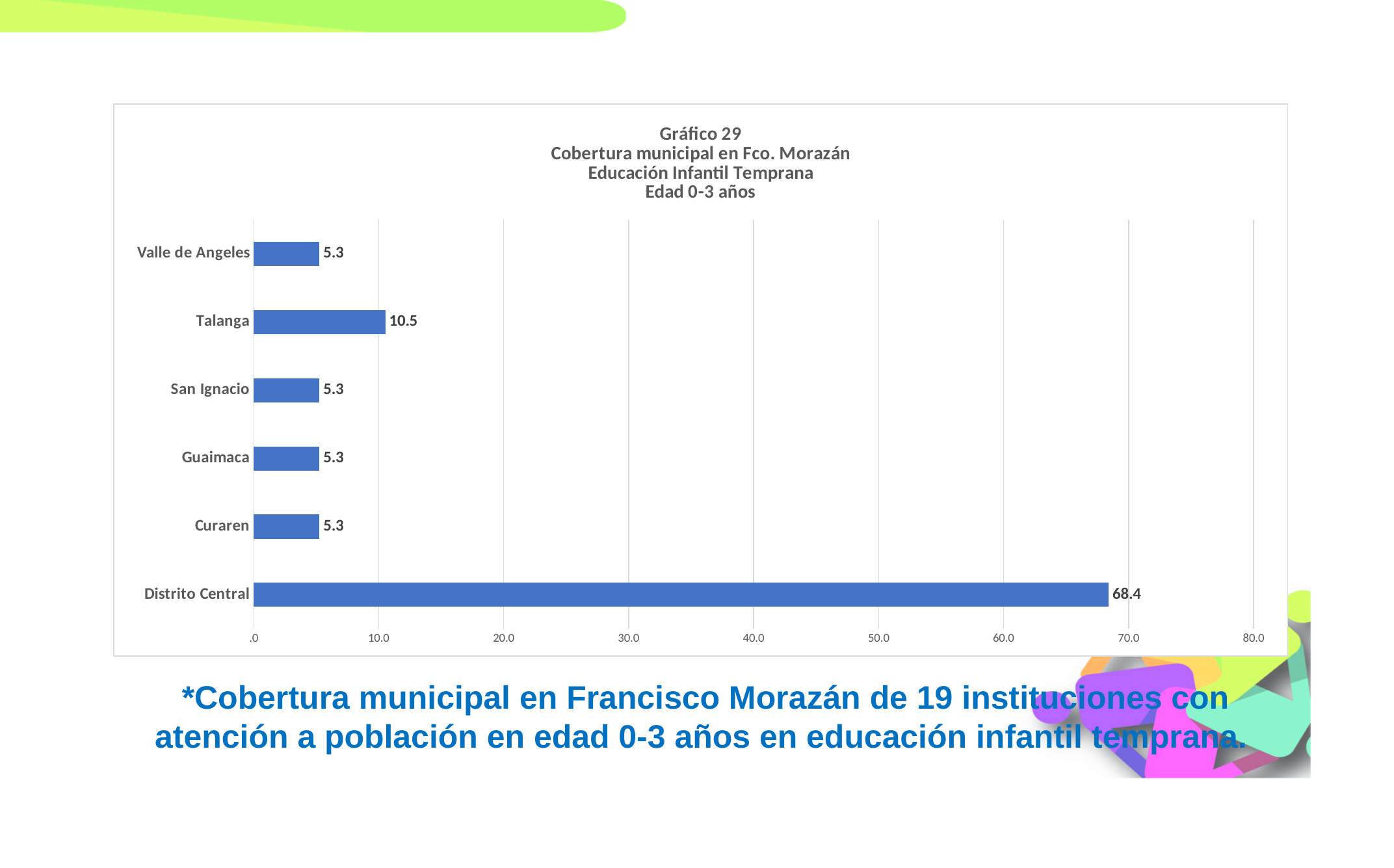
What is the value for Talanga? 10.5 Is the value for Distrito Central greater or less than 60.0? greater What kind of chart is shown on the slide? bar chart What is the value for Distrito Central? 68.4 Is the value for Curaren greater or less than 10.0? less How many categories are shown in the chart? 6 What is the value for Valle de Angeles? 5.3 What is the chart number given in the chart title? Gráfico 29 Which is larger, the value for Talanga or the value for San Ignacio? Talanga What is the difference between the values for Distrito Central and Talanga? 57.9 What is the difference between the values for Talanga and Guaimaca? 5.2 Which category has the highest value? Distrito Central